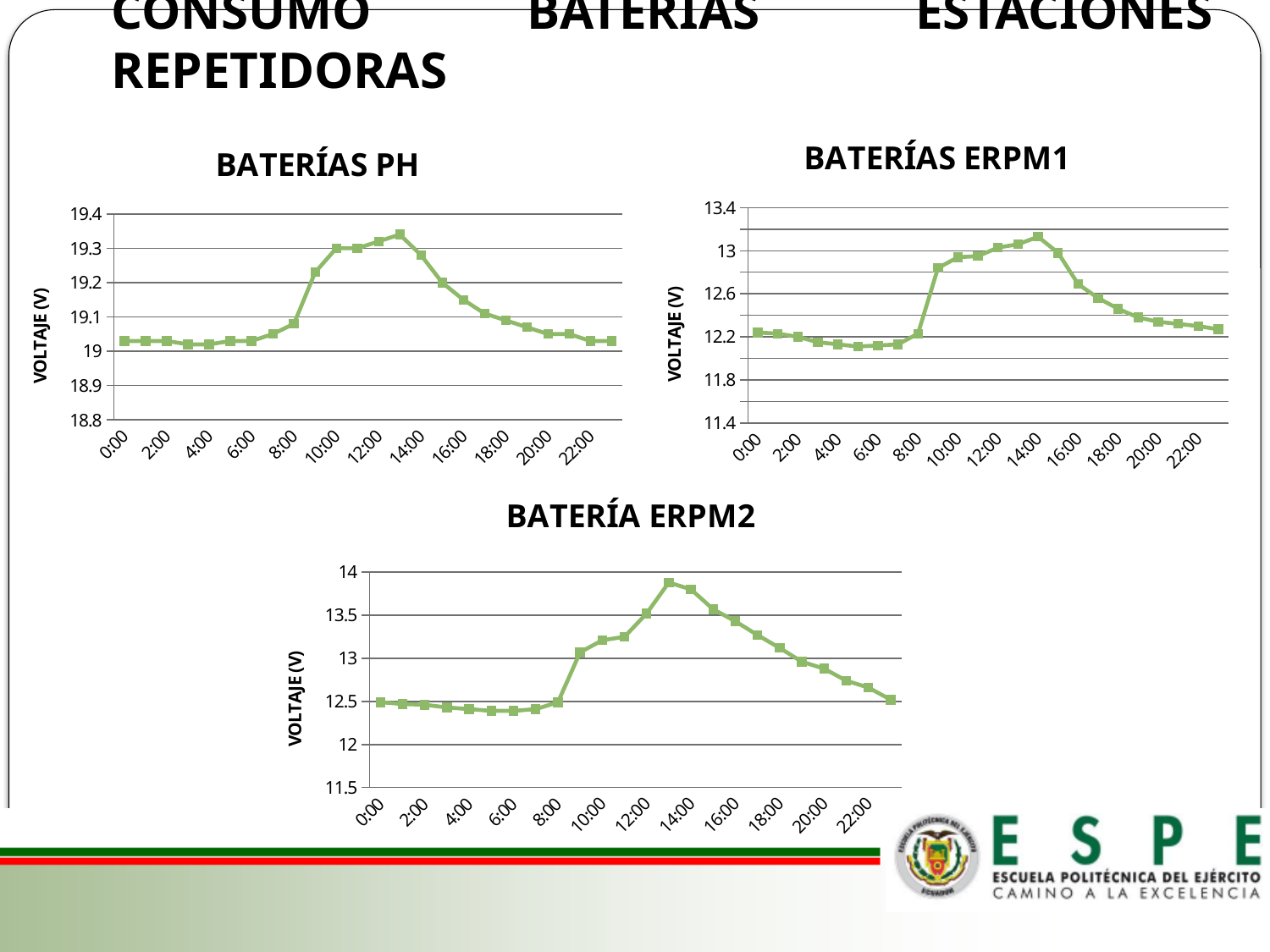
In the BATERÍAS PH chart, do the values rise or fall between 14:00 and 22:00? fall How many charts are shown on the slide? 3 In the BATERÍA ERPM2 chart, do the values rise or fall between 8:00 and 14:00? rise In the BATERÍA ERPM2 chart, is the highest value greater or less than 13.5? greater In the BATERÍAS PH chart, is the value at 0:00 greater or less than 19.2? less In the BATERÍA ERPM2 chart, is the value at 6:00 greater or less than 13? less What kind of chart is the BATERÍAS PH chart? line chart In the BATERÍAS PH chart, which is larger, the value at 12:00 or the value at 4:00? 12:00 What is the y-axis title of the BATERÍA ERPM2 chart? VOLTAJE (V)